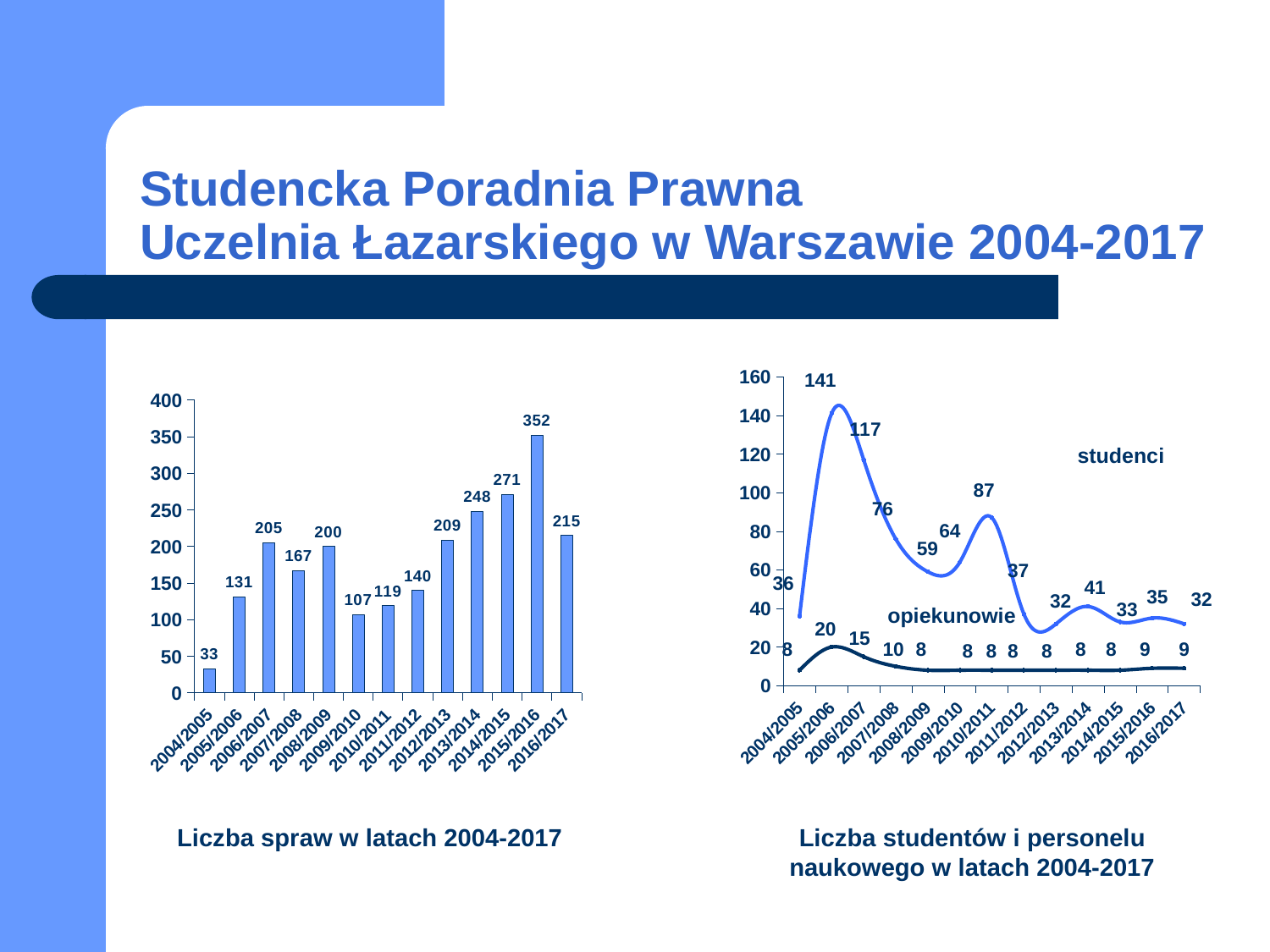
In the chart titled 'Liczba spraw w latach 2004-2017', what is the value for 2015/2016? 352 In the chart titled 'Liczba spraw w latach 2004-2017', which is larger: the value for 2006/2007 or the value for 2008/2009? 2006/2007 In the chart titled 'Liczba spraw w latach 2004-2017', which year has the lowest value? 2004/2005 In the chart titled 'Liczba studentów i personelu naukowego w latach 2004-2017', how many series are plotted? 2 What kind of chart is the chart titled 'Liczba studentów i personelu naukowego w latach 2004-2017'? line chart In the chart titled 'Liczba spraw w latach 2004-2017', which year has the highest value? 2015/2016 In the chart titled 'Liczba spraw w latach 2004-2017', how many years are shown on the x axis? 13 In the chart titled 'Liczba studentów i personelu naukowego w latach 2004-2017', what is the difference between studenci and opiekunowie in 2010/2011? 79 In the chart titled 'Liczba spraw w latach 2004-2017', what is the difference between the values for 2015/2016 and 2016/2017? 137 What kind of chart is the chart titled 'Liczba spraw w latach 2004-2017'? bar chart In the chart titled 'Liczba studentów i personelu naukowego w latach 2004-2017', what is the value for studenci in 2005/2006? 141 In the chart titled 'Liczba studentów i personelu naukowego w latach 2004-2017', what is the value for opiekunowie in 2006/2007? 15